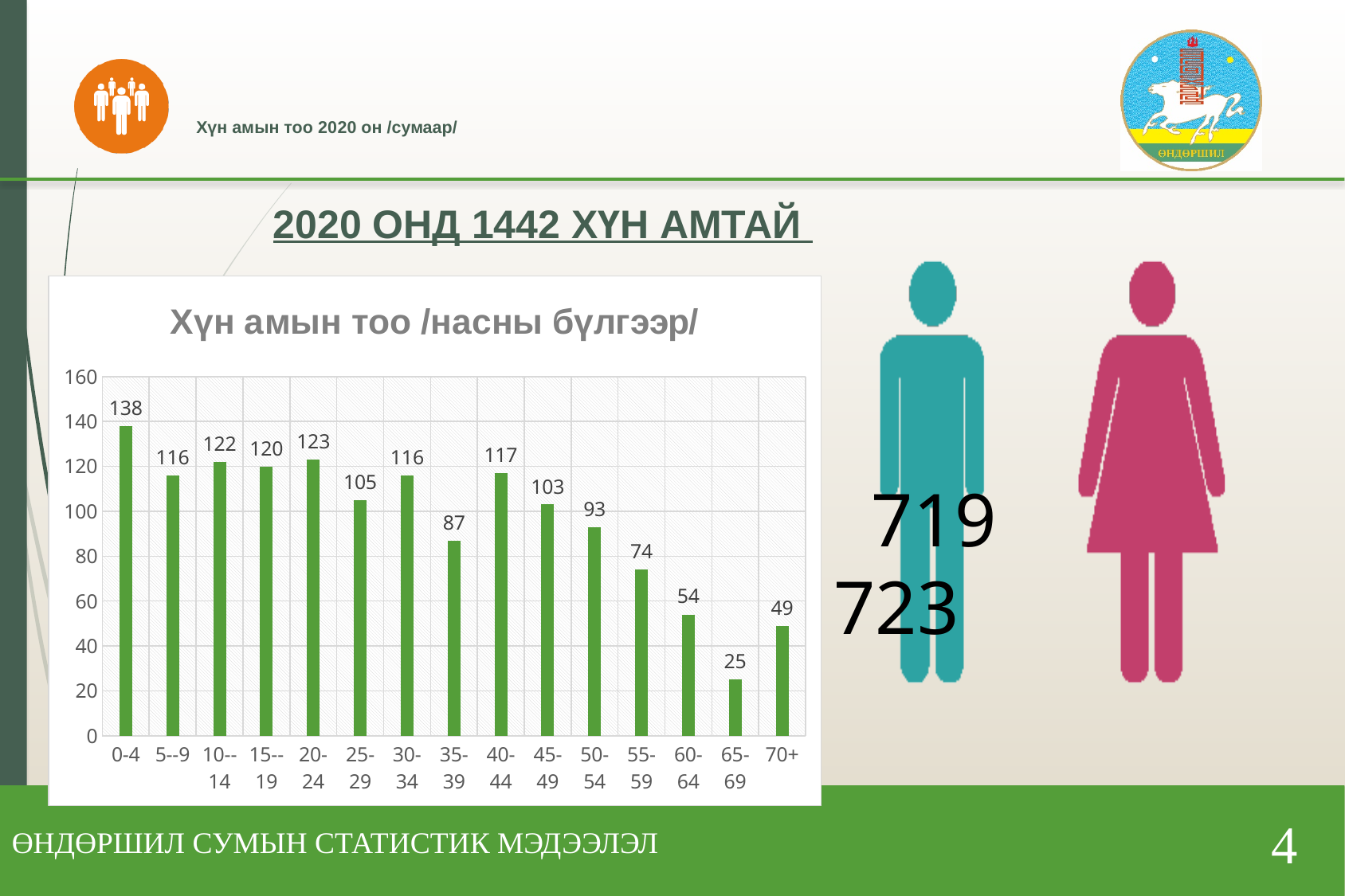
What is the difference between the values for the 20-24 and 25-29 age groups? 18 What kind of chart is shown on the slide? bar chart Which age group has the highest value? 0-4 Which is larger, the value for 55-59 or the value for 60-64? 55-59 What is the difference between the values for the 0-4 and 65-69 age groups? 113 How many age groups are shown on the chart? 15 What is the value for the 35-39 age group? 87 Which age group has the lowest value? 65-69 What is the value for the 0-4 age group? 138 Is the value for the 50-54 age group greater or less than 100? less What is the title of the chart? Хүн амын тоо /насны бүлгээр/ What is the value for the 70+ age group? 49